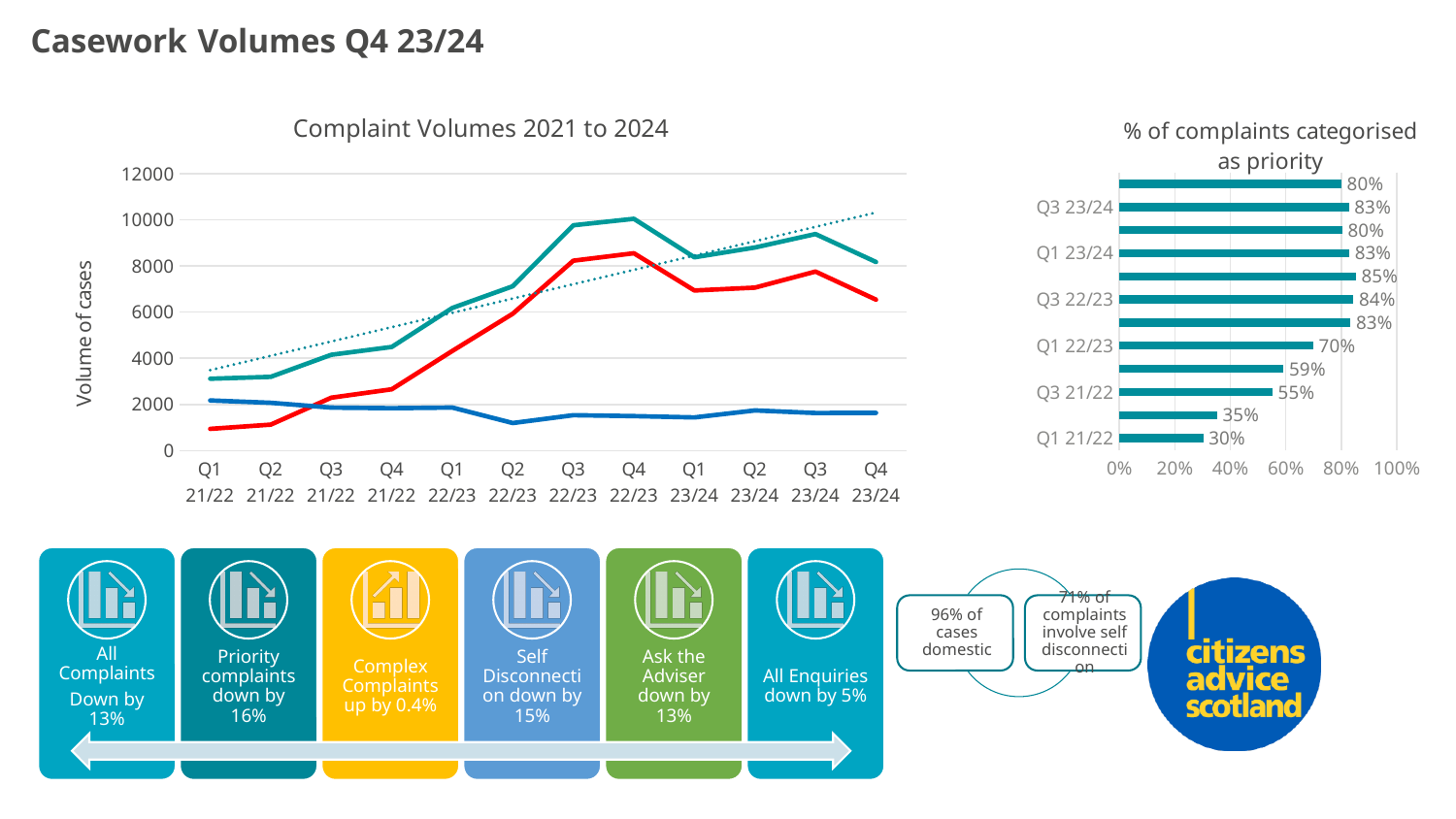
How many bars are in the '% of complaints categorised as priority' chart? 12 In the '% of complaints categorised as priority' chart, what is the difference between Q1 22/23 and Q1 21/22? 40% In the '% of complaints categorised as priority' chart, which is larger, Q3 21/22 or Q3 22/23? Q3 22/23 In the '% of complaints categorised as priority' chart, what is the value for Q1 21/22? 30% In the 'Complaint Volumes 2021 to 2024' chart, is the value of the teal line at Q3 22/23 greater or less than 8000? greater What kind of chart is 'Complaint Volumes 2021 to 2024'? Line chart In the '% of complaints categorised as priority' chart, what is the highest value shown? 85% In the 'Complaint Volumes 2021 to 2024' chart, is the value of the red line at Q1 21/22 greater or less than 2000? less In the '% of complaints categorised as priority' chart, which quarter has the lowest value? Q1 21/22 In the '% of complaints categorised as priority' chart, what is the value for Q3 22/23? 84% What kind of chart is '% of complaints categorised as priority'? Bar chart In the '% of complaints categorised as priority' chart, what is the value for Q1 23/24? 83%